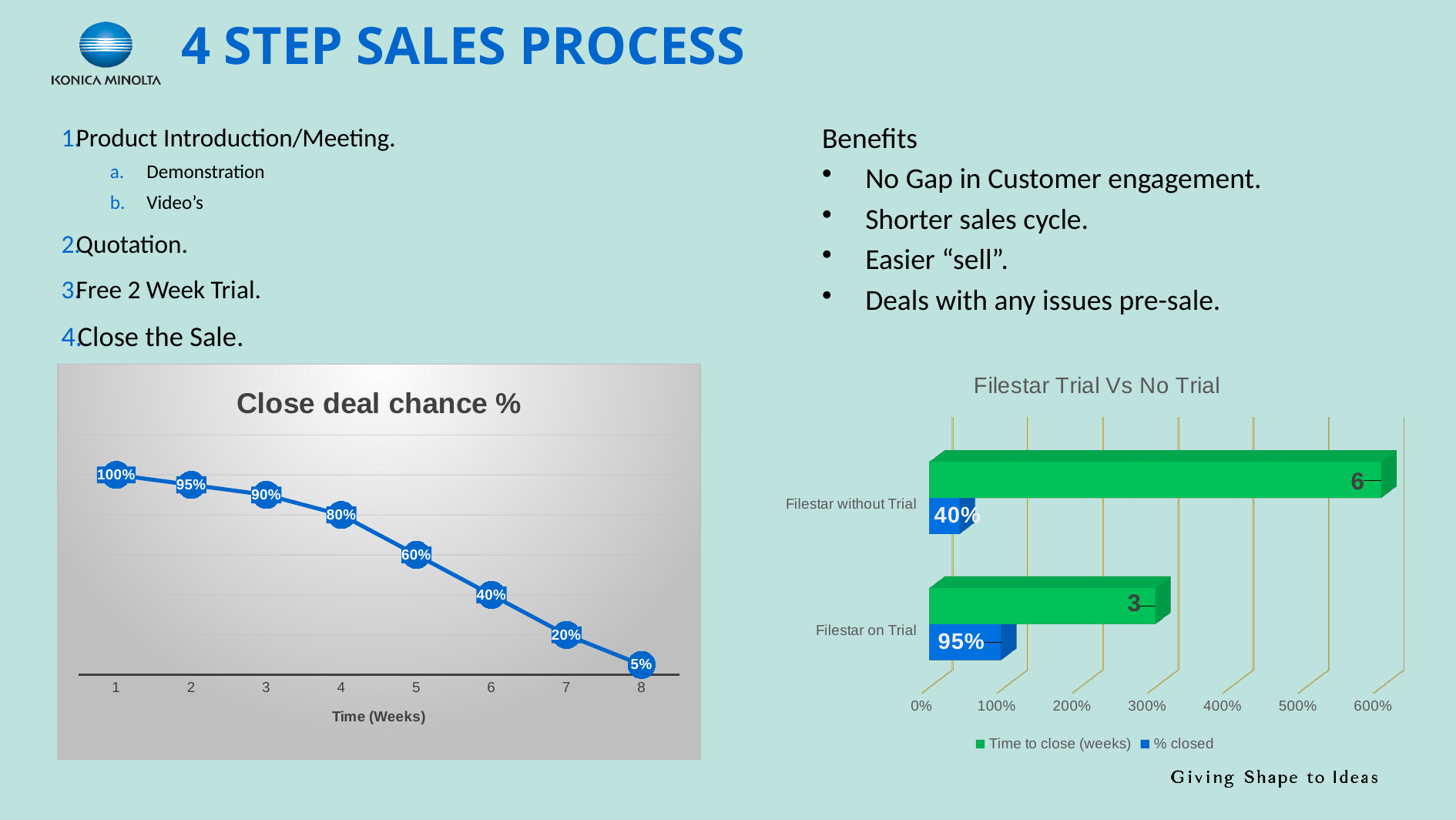
In the 'Filestar Trial Vs No Trial' chart, what is the % closed for Filestar on Trial? 95% In the 'Close deal chance %' chart, what is the value at week 8? 5% In the 'Close deal chance %' chart, what is the value at week 4? 80% What kind of chart is the 'Filestar Trial Vs No Trial' chart? bar chart In the 'Close deal chance %' chart, what is the difference between the values at week 5 and week 6? 20% In the 'Close deal chance %' chart, how many weeks are plotted on the x axis? 8 What kind of chart is the 'Close deal chance %' chart? line chart In the 'Filestar Trial Vs No Trial' chart, what is the time to close (weeks) for Filestar without Trial? 6 In the 'Close deal chance %' chart, do the values rise or fall as the weeks increase? fall In the 'Close deal chance %' chart, which week has the highest close deal chance? 1 In the 'Filestar Trial Vs No Trial' chart, which category has the higher % closed? Filestar on Trial How many series does the legend of the 'Filestar Trial Vs No Trial' chart list? 2